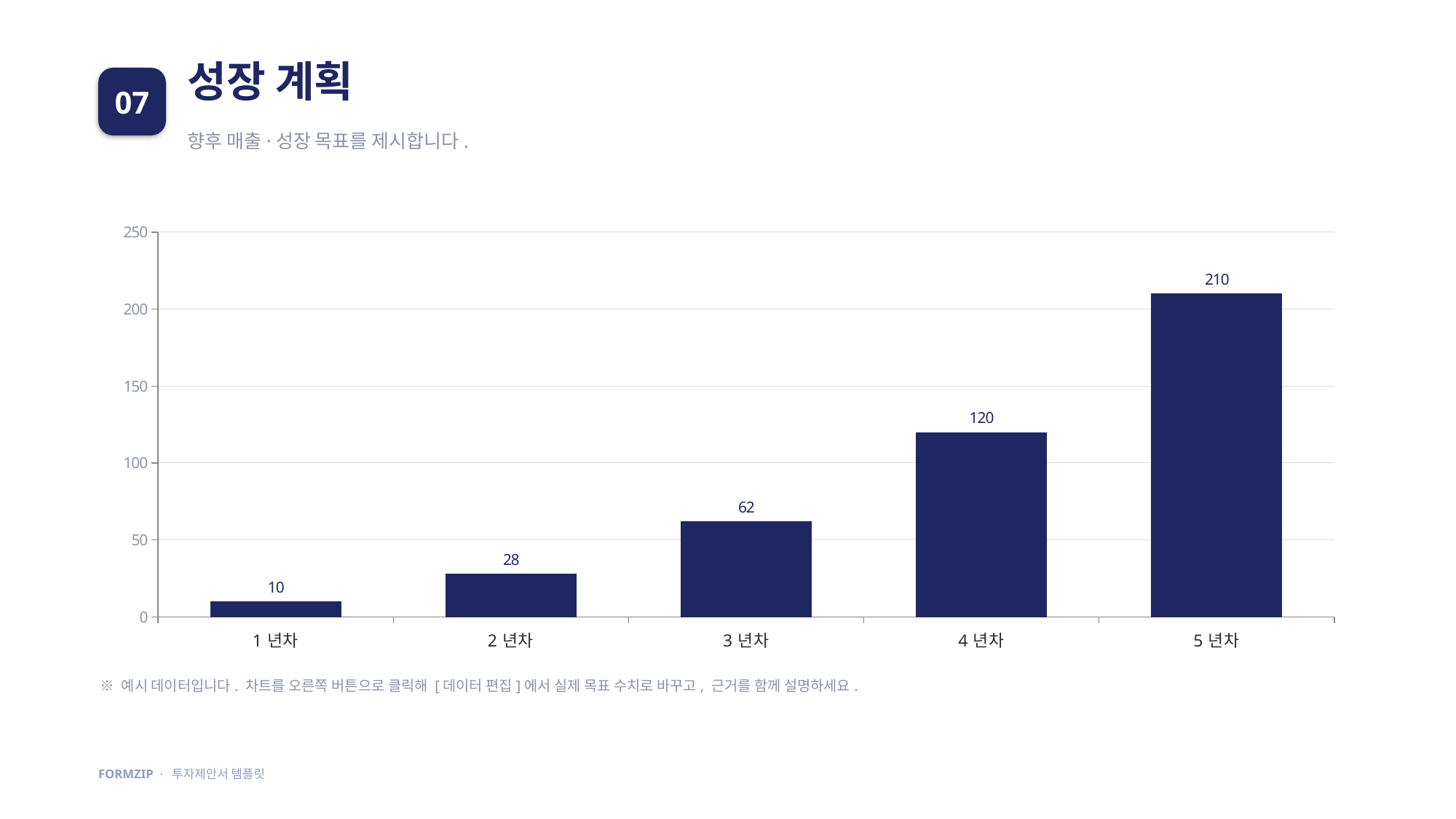
Is the value for 4 년차 greater or less than 100? greater What is the value for 3 년차? 62 Which is larger, the value for 3 년차 or the value for 4 년차? 4 년차 Do the values rise or fall from 1 년차 to 5 년차? rise What is the difference between the values for 5 년차 and 4 년차? 90 Which category has the highest value? 5 년차 How many categories are shown on the x axis? 5 What is the value for 5 년차? 210 What kind of chart is shown on the slide? bar chart What is the difference between the values for 2 년차 and 1 년차? 18 Which category has the lowest value? 1 년차 What is the value for 1 년차? 10